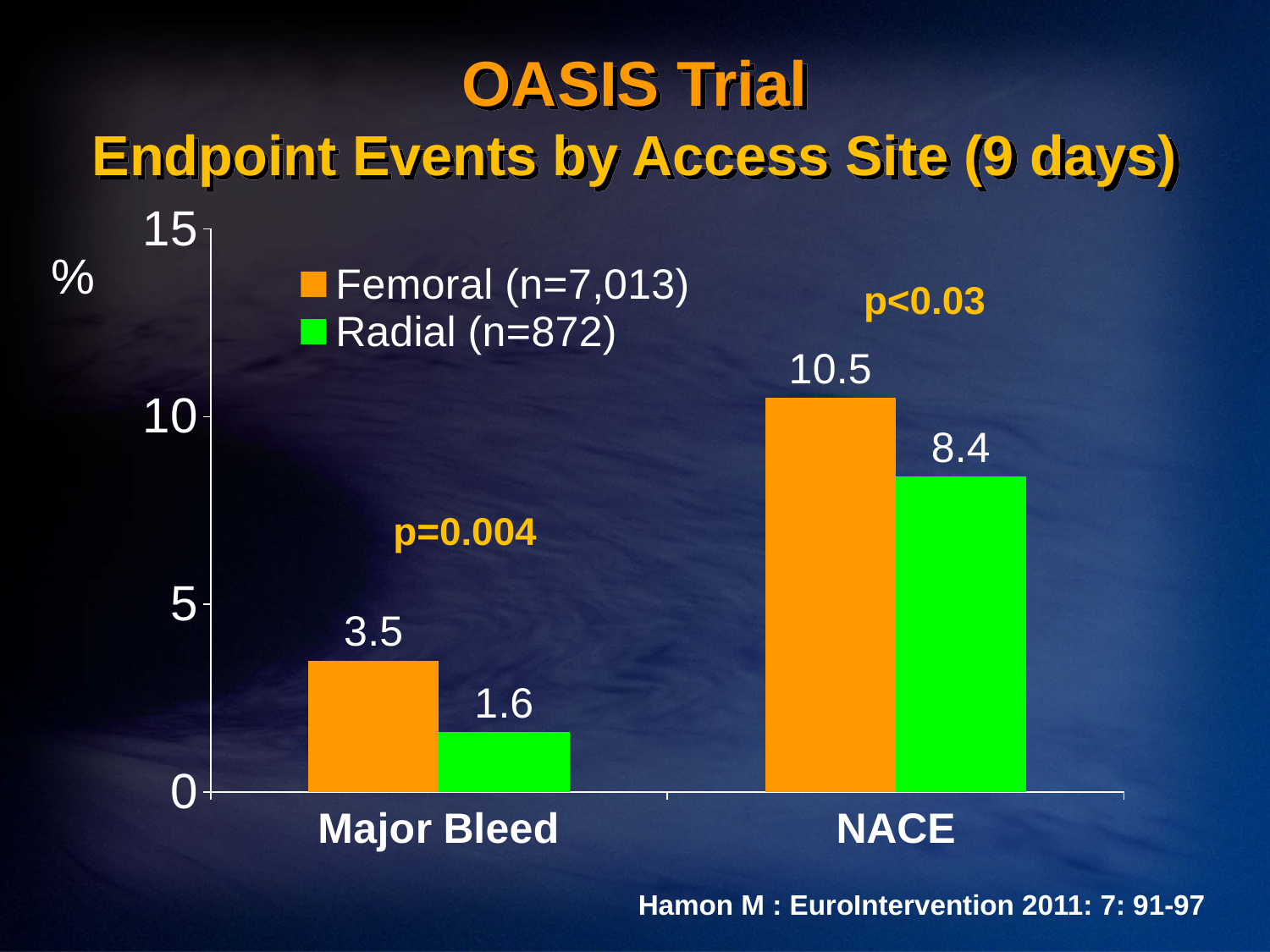
Which bar has the lowest value on the chart? Radial, Major Bleed Which is larger for Major Bleed, the Femoral value or the Radial value? Femoral What is the difference between the Femoral and Radial values for Major Bleed? 1.9 What is the difference between the Femoral and Radial values for NACE? 2.1 What is the Femoral value for Major Bleed? 3.5 What is the Radial value for Major Bleed? 1.6 How many series does the legend list? 2 Which category has the highest Femoral value? NACE How many categories are shown on the x axis? 2 What is the Radial value for NACE? 8.4 What is the Femoral value for NACE? 10.5 What kind of chart is shown on the slide? Bar chart